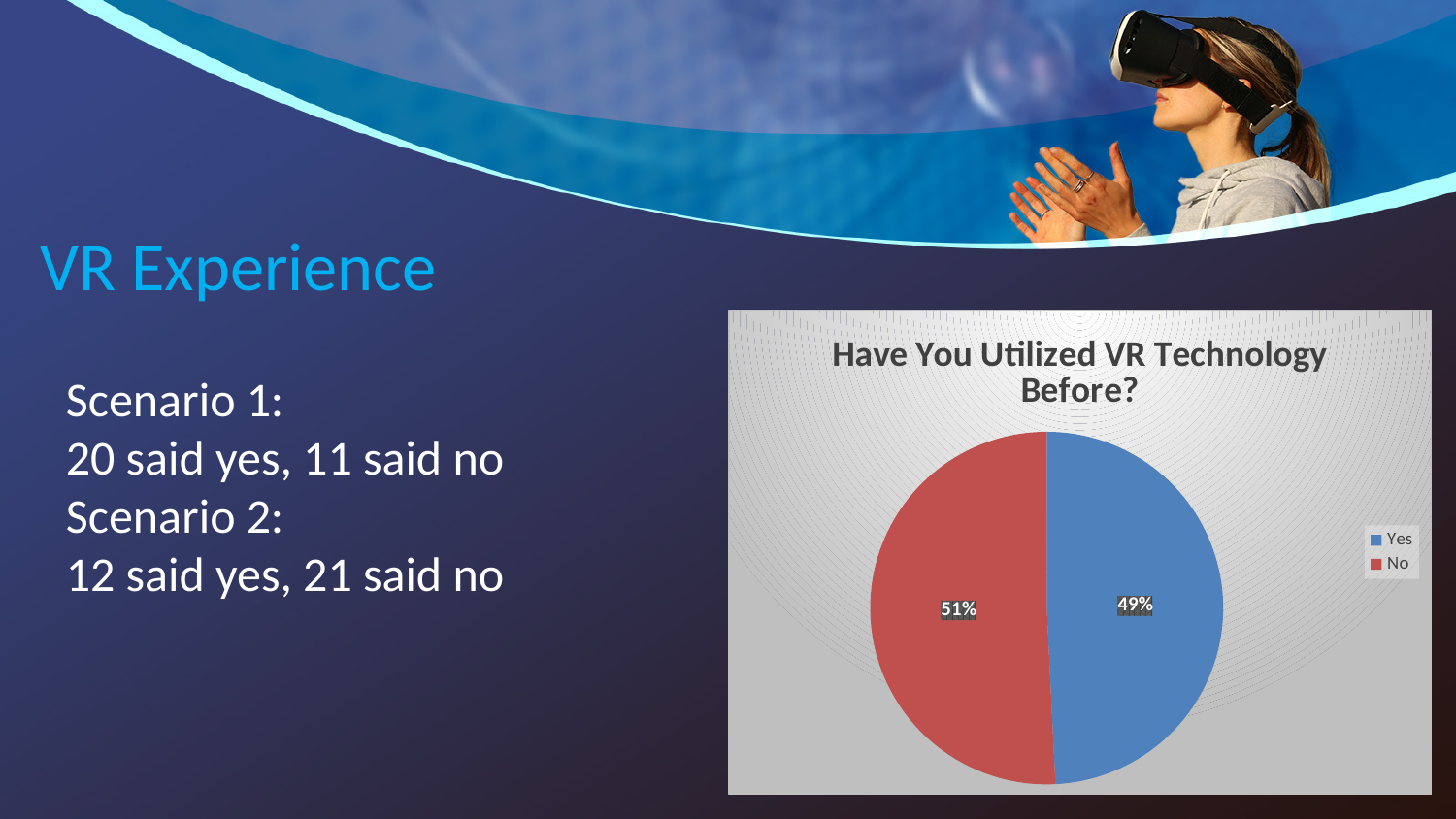
What is the title of the chart? Have You Utilized VR Technology Before? How many entries does the legend list? 2 Which slice of the pie is larger, Yes or No? No What percentage of the pie is labelled "Yes"? 49% What colour is the "Yes" slice? blue What percentage of the pie is labelled "No"? 51% Which category has the largest share of the pie? No How many slices does the pie chart have? 2 What is the difference in percentage points between the No slice and the Yes slice? 2 What kind of chart is shown on the slide? pie chart Which category has the smallest share of the pie? Yes What share of the pie does the No slice represent? 51%